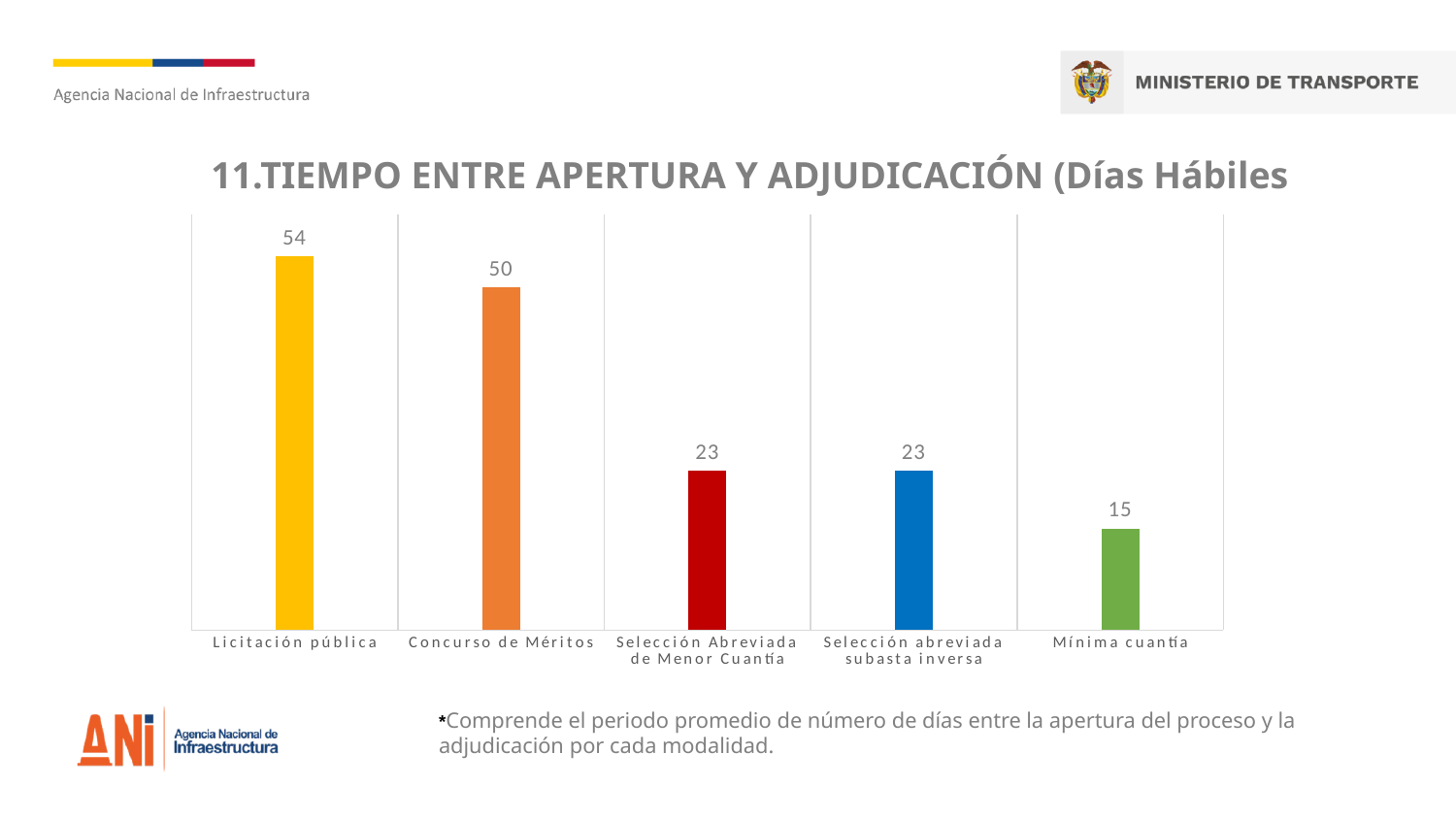
Which is larger, the value for Concurso de Méritos or the value for Mínima cuantía? Concurso de Méritos What is the difference between the values for Selección Abreviada de Menor Cuantía and Mínima cuantía? 8 What colour is the bar for Selección abreviada subasta inversa? Blue What is the value for Licitación pública? 54 Which category has the lowest value? Mínima cuantía What is the value for Selección abreviada subasta inversa? 23 What is the difference between the values for Licitación pública and Concurso de Méritos? 4 What is the value for Concurso de Méritos? 50 What kind of chart is shown on the slide? Bar chart Which category has the highest value? Licitación pública What is the value for Mínima cuantía? 15 How many categories are shown in the chart? 5